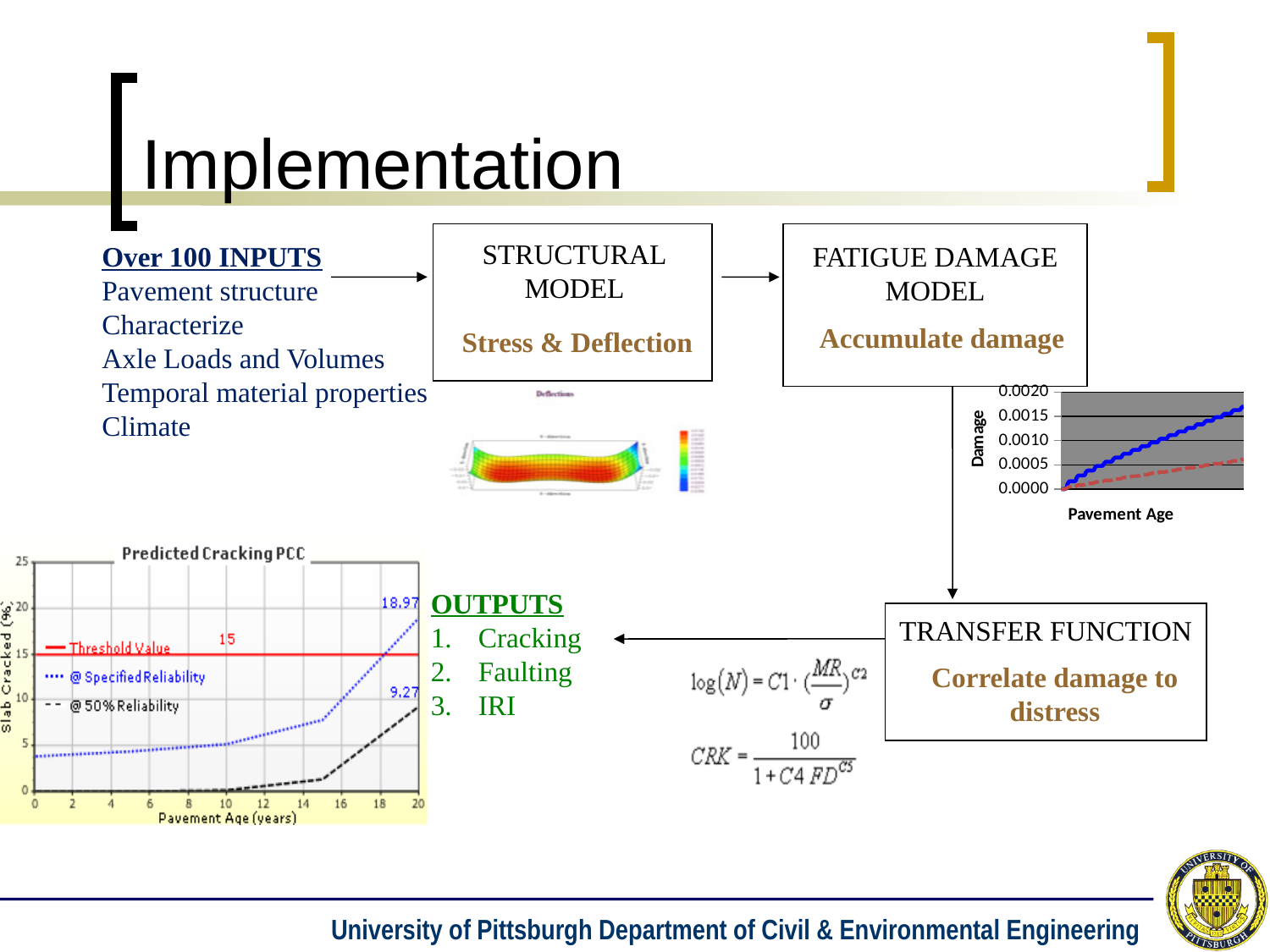
In the Predicted Cracking PCC chart, what is the value of the @ 50% Reliability series at a pavement age of 20 years? 9.27 In the Predicted Cracking PCC chart, what is the value of the @ Specified Reliability series at a pavement age of 20 years? 18.97 In the Damage vs Pavement Age chart on the right, does the solid blue line rise or fall as pavement age increases? rise In the Damage vs Pavement Age chart on the right, is the final value of the solid blue line greater or less than 0.0015? greater In the Predicted Cracking PCC chart, does the @ Specified Reliability series rise or fall as pavement age increases? rise What is the title of the line chart in the bottom-left of the slide? Predicted Cracking PCC In the Predicted Cracking PCC chart, what is the difference between the @ Specified Reliability and @ 50% Reliability values at 20 years? 9.70 In the Predicted Cracking PCC chart, which series has the larger value at 20 years: @ Specified Reliability or @ 50% Reliability? @ Specified Reliability In the Predicted Cracking PCC chart, is the @ 50% Reliability value at 20 years greater or less than 10? less In the Predicted Cracking PCC chart, how many series does the legend list? 3 What kind of chart is the Predicted Cracking PCC chart? line chart In the Predicted Cracking PCC chart, what is the Threshold Value? 15